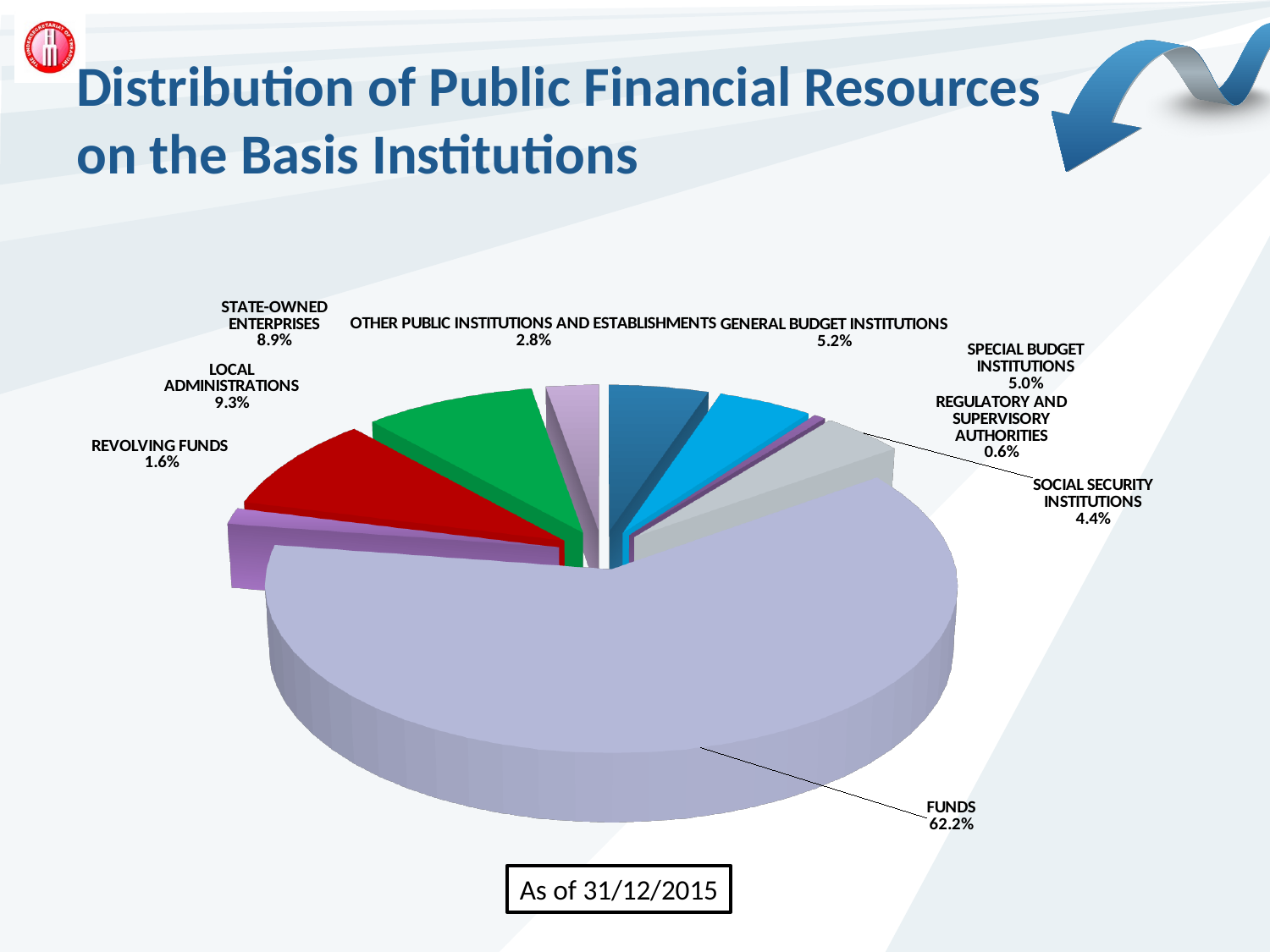
Which is larger, the share of General Budget Institutions or Special Budget Institutions? General Budget Institutions What is the value for Social Security Institutions? 4.4% Which category has the smallest share of the pie? Regulatory and Supervisory Authorities What is the value for Regulatory and Supervisory Authorities? 0.6% What is the difference between the shares of Local Administrations and State-Owned Enterprises? 0.4% What date is the chart data stated to be as of? 31/12/2015 Which category has the largest share of the pie? Funds What is the value for State-Owned Enterprises? 8.9% What is the value for Local Administrations? 9.3% What kind of chart is shown on the slide? Pie chart What share of public financial resources is held by Funds? 62.2% How many categories are shown in the pie chart? 9